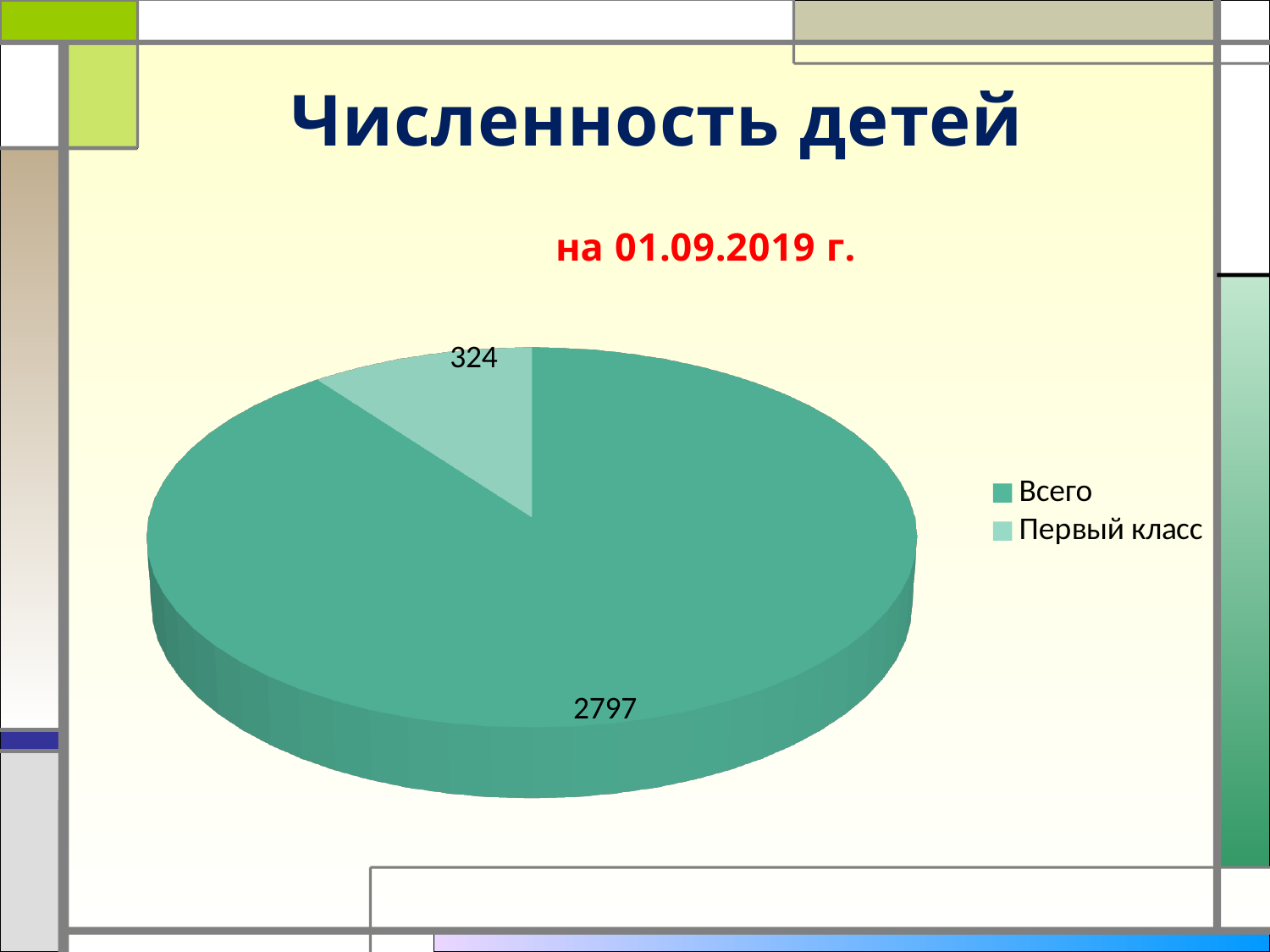
Which slice is the smallest? Первый класс What is the value for Первый класс? 324 What is the difference between the values for Всего and Первый класс? 2473 Which slice is the largest? Всего What type of chart is shown on the slide? pie chart What is the title of the slide containing the chart? Численность детей What date is given in the subtitle above the chart? на 01.09.2019 г. Which is larger, Всего or Первый класс? Всего What is the value for Всего? 2797 How many entries does the legend list? 2 How many slices does the pie chart have? 2